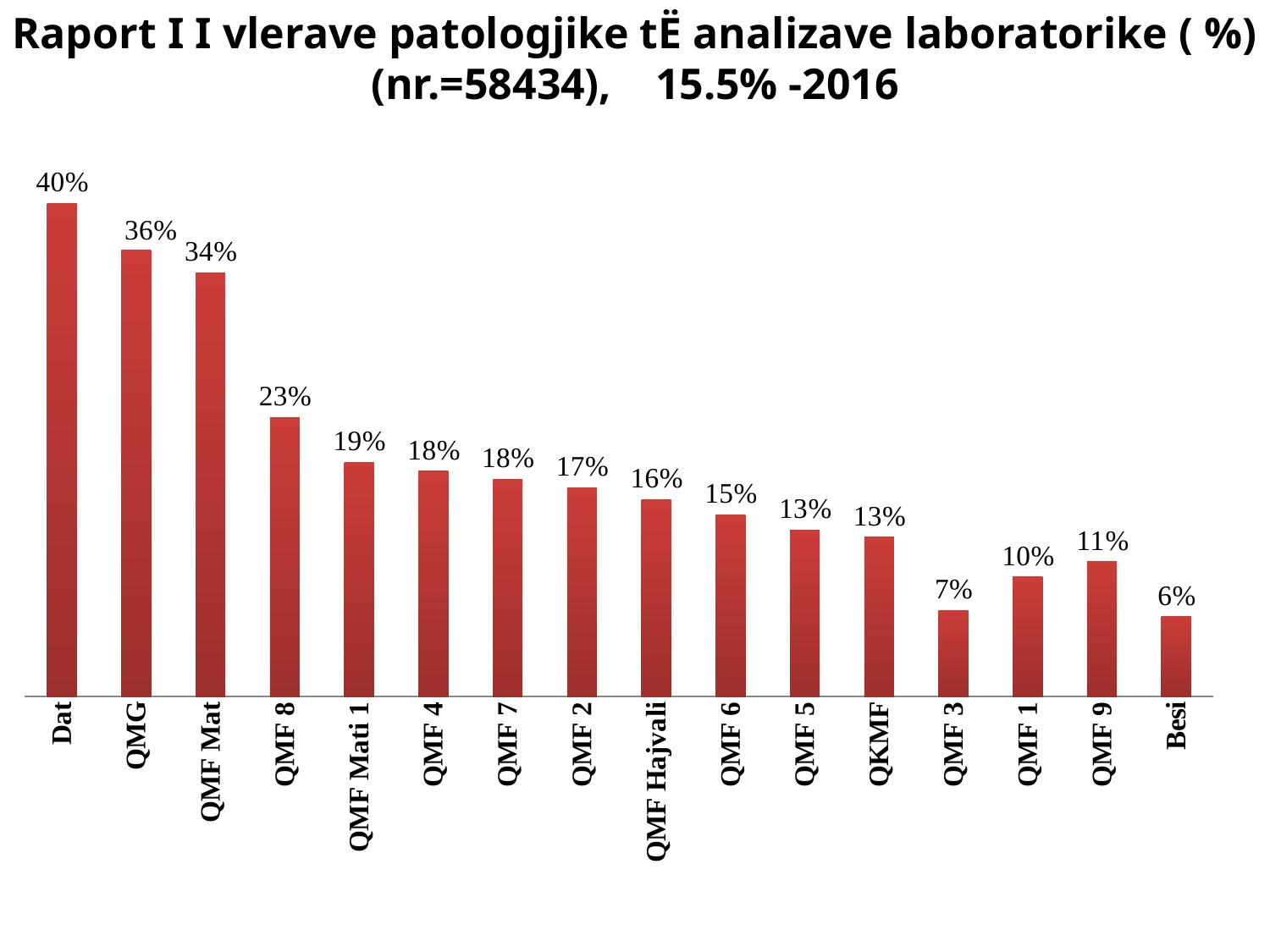
How many categories are shown on the x axis? 16 What is the difference between the values for Dat and QMG? 4% What is the value for QKMF? 13% What is the difference between the values for QMF 8 and QMF 3? 16% Which is larger, the value for QMF 9 or the value for QMF 1? QMF 9 What kind of chart is shown on the slide? Bar chart What is the value for QMF Hajvali? 16% What is the value for QMF 8? 23% Which is larger, the value for QMF Mat or the value for QMF Mati 1? QMF Mat Which category has the highest value? Dat Which category has the lowest value? Besi Do the values generally rise or fall from left to right along the x axis? Fall